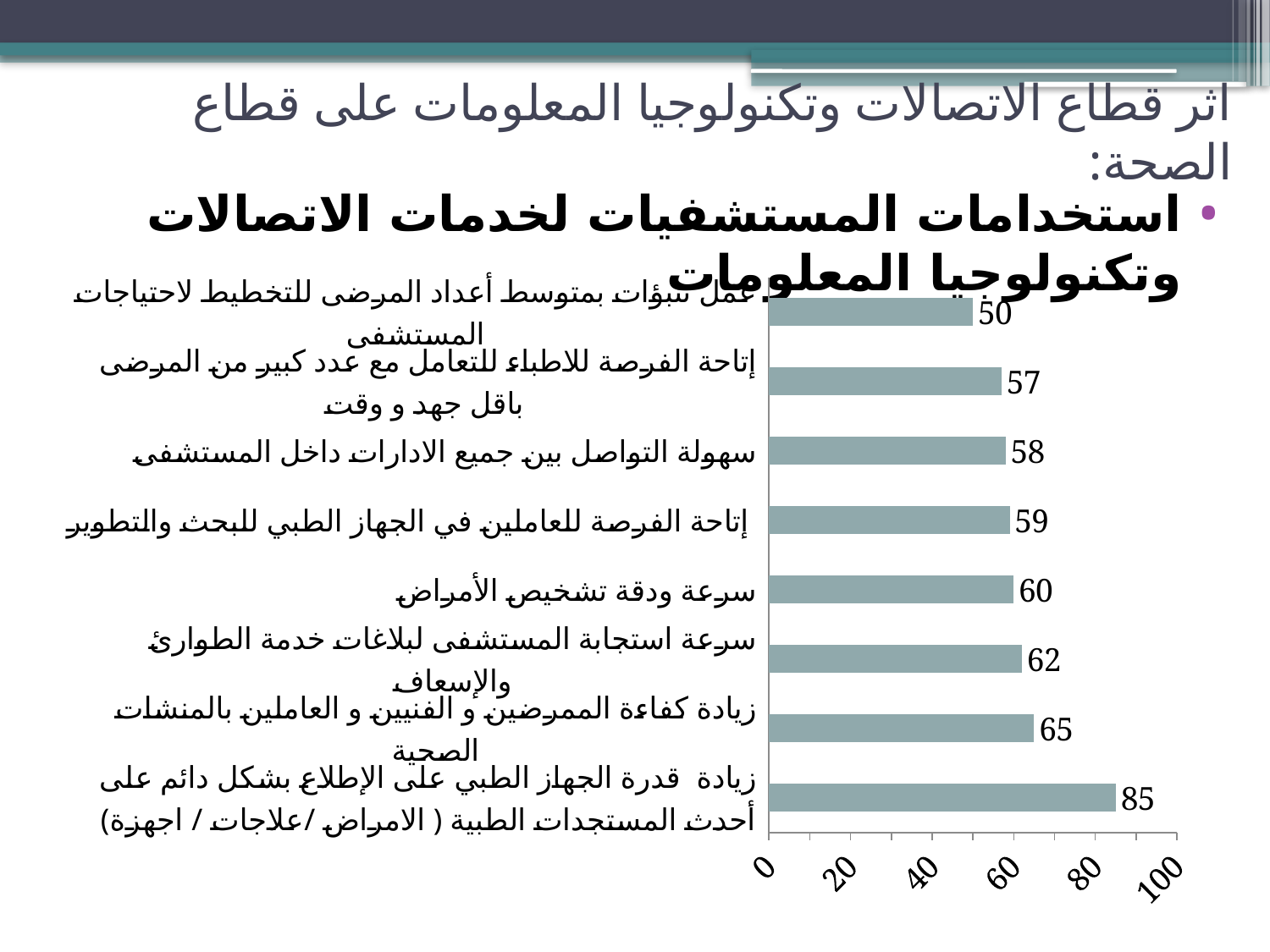
How many categories are shown in the chart? 8 What is the value for "سرعة ودقة تشخيص الأمراض"? 60 What kind of chart is shown on the slide? bar chart What is the difference between the values for "سرعة استجابة المستشفى لبلاغات خدمة الطوارئ والإسعاف" and "سرعة ودقة تشخيص الأمراض"? 2 Which category has the highest value? زيادة قدرة الجهاز الطبي على الإطلاع بشكل دائم على أحدث المستجدات الطبية (الامراض/علاجات/اجهزة) What is the value for "زيادة كفاءة الممرضين و الفنيين و العاملين بالمنشات الصحية"? 65 What is the difference between the highest value (85) and the lowest value (50)? 35 What is the value for "سهولة التواصل بين جميع الادارات داخل المستشفى"? 58 Which category has the lowest value? عمل تنبؤات بمتوسط أعداد المرضى للتخطيط لاحتياجات المستشفى Which is larger: the value for "إتاحة الفرصة للعاملين في الجهاز الطبي للبحث والتطوير" or the value for "عمل تنبؤات بمتوسط أعداد المرضى للتخطيط لاحتياجات المستشفى"? إتاحة الفرصة للعاملين في الجهاز الطبي للبحث والتطوير Is the value for "إتاحة الفرصة للاطباء للتعامل مع عدد كبير من المرضى باقل جهد و وقت" greater or less than 40? greater What is the maximum value shown on the horizontal axis? 100